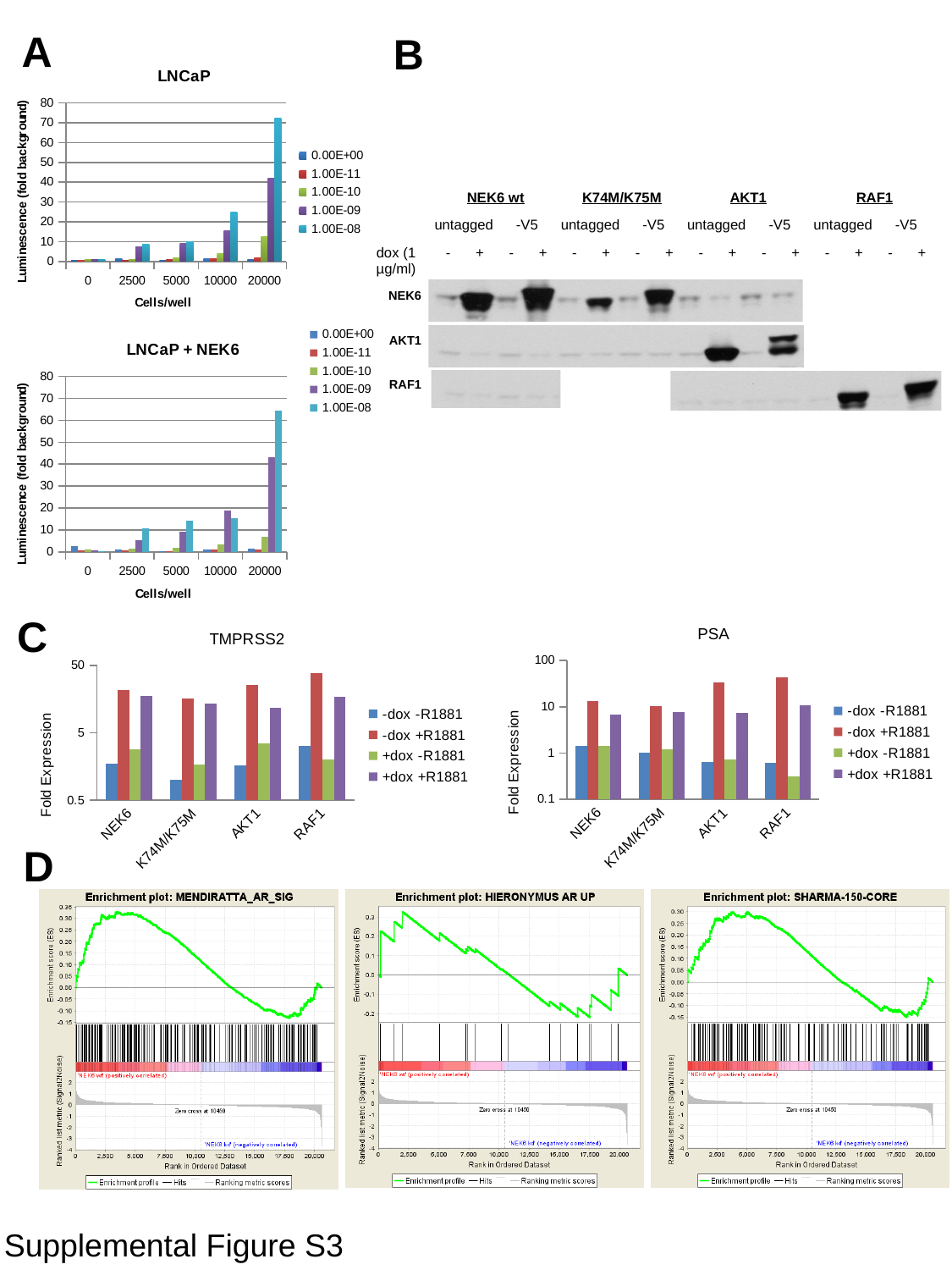
In the TMPRSS2 chart, how many series does the legend list? 4 In the LNCaP + NEK6 chart, do the luminescence values for the 1.00E-08 series rise or fall as Cells/well increases? rise In the LNCaP chart, how many Cells/well categories are shown on the x axis? 5 In the LNCaP chart, which Cells/well category has the highest luminescence bar? 20000 In the PSA chart, which is larger for AKT1: -dox +R1881 or +dox -R1881? -dox +R1881 In the LNCaP chart, is the value for the 1.00E-08 series at 20000 cells/well greater or less than 60? greater In the PSA chart, is the value for -dox +R1881 at AKT1 greater or less than 10? greater What kind of chart is the TMPRSS2 chart? bar chart In the LNCaP + NEK6 chart, is the value for the 1.00E-08 series at 20000 cells/well greater or less than 60? greater In the LNCaP chart, how many series does the legend list? 5 In the PSA chart, which series has the tallest bar for RAF1? -dox +R1881 In the LNCaP + NEK6 chart, which series has the tallest bar at 20000 cells/well? 1.00E-08